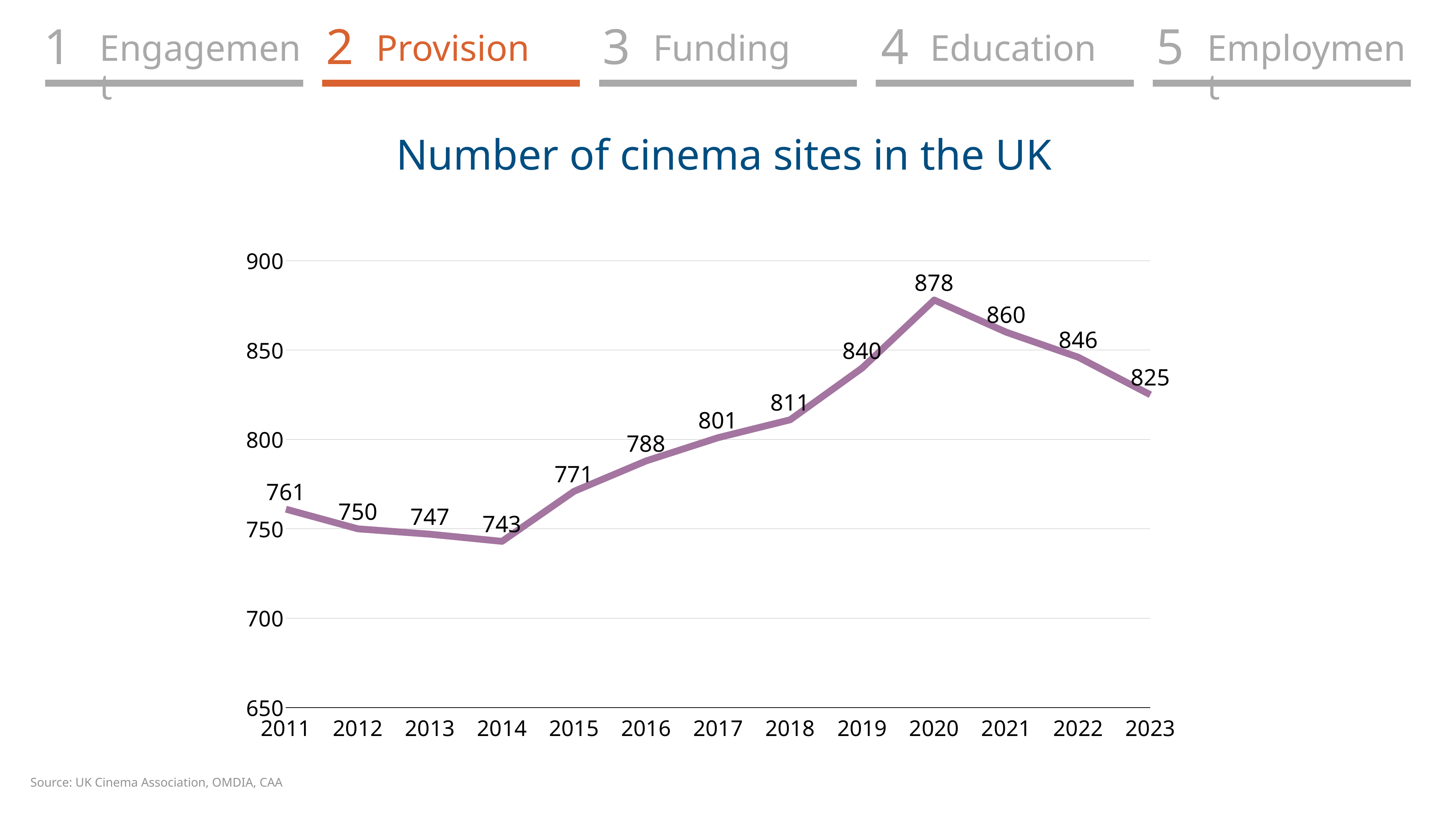
Did the number of cinema sites in the UK rise or fall between 2014 and 2020? Rise What was the number of cinema sites in the UK in 2020? 878 Which year had the lowest number of cinema sites in the UK? 2014 Which year had more cinema sites, 2017 or 2021? 2021 How many years are plotted on the chart? 13 Which year had the highest number of cinema sites in the UK? 2020 What type of chart is used to show the number of cinema sites in the UK? Line chart What was the number of cinema sites in the UK in 2014? 743 Is the number of cinema sites in 2019 greater or less than 800? greater By how much did the number of cinema sites in the UK change between 2020 and 2023? 53 What is the difference in the number of cinema sites between 2011 and 2014? 18 What was the number of cinema sites in the UK in 2023? 825